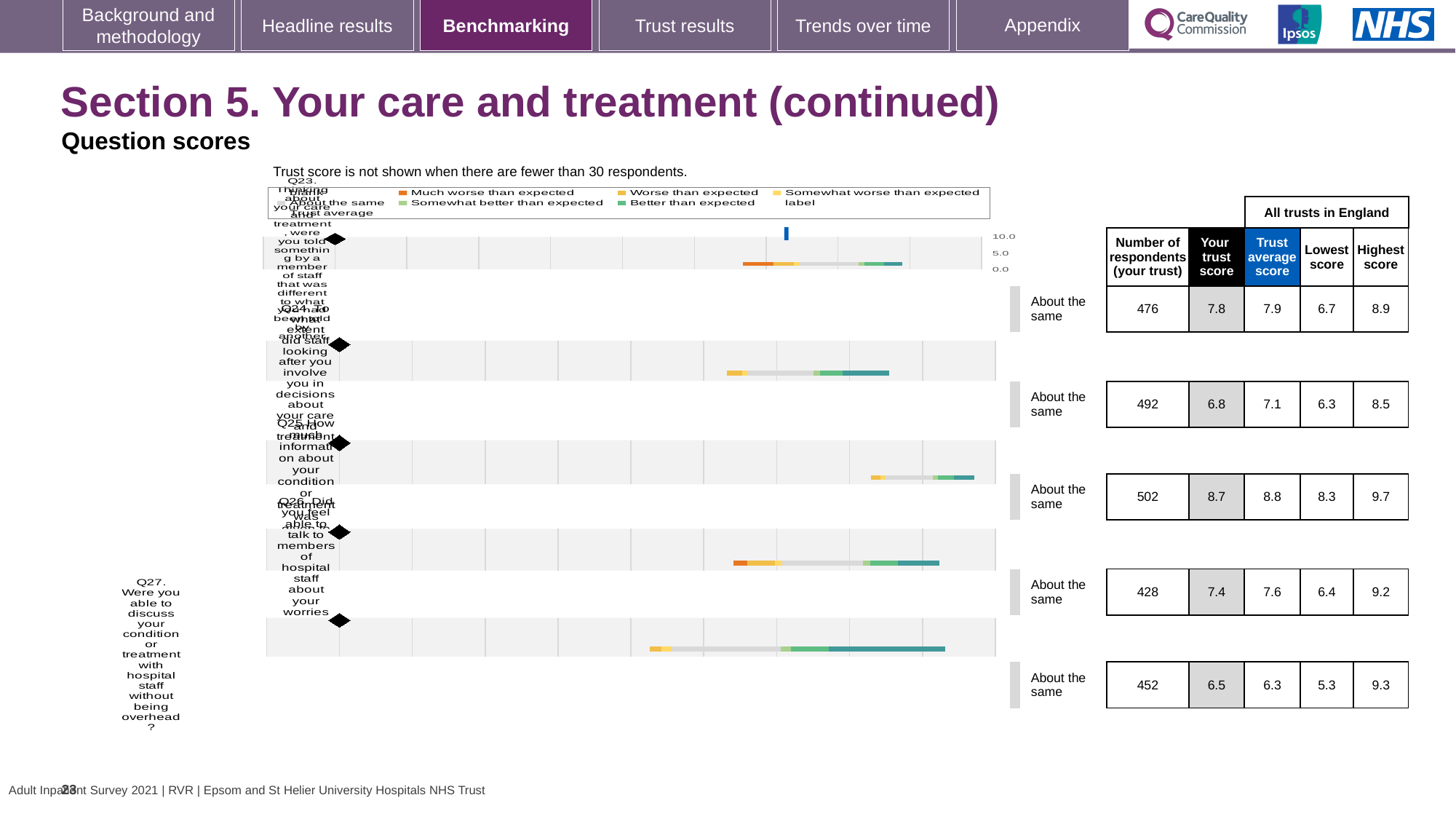
Which question has the highest 'Your trust score'? Q25 For Q24, what is the difference between the 'Trust average score' and 'Your trust score'? 0.3 What is the 'Your trust score' for Q23 (were you told something by a member of staff that was different to what another member of staff told you)? 7.8 What is the 'Trust average score' for Q26 (did you feel able to talk to members of hospital staff about your worries)? 7.6 Which question has the lowest 'Your trust score'? Q27 How many respondents (your trust) are shown for Q25 (how much information about your condition or treatment was given to you)? 502 Which question has the most respondents (your trust)? Q25 What is the 'Highest score' for Q27 (were you able to discuss your condition or treatment with hospital staff without being overheard)? 9.3 How many questions are plotted on the chart? 5 What is the 'Lowest score' for Q24 (to what extent did staff looking after you involve you in decisions about your care and treatment)? 6.3 What kind of chart is used to show the question scores? Bar chart For Q27, which is larger: 'Your trust score' or 'Trust average score'? Your trust score